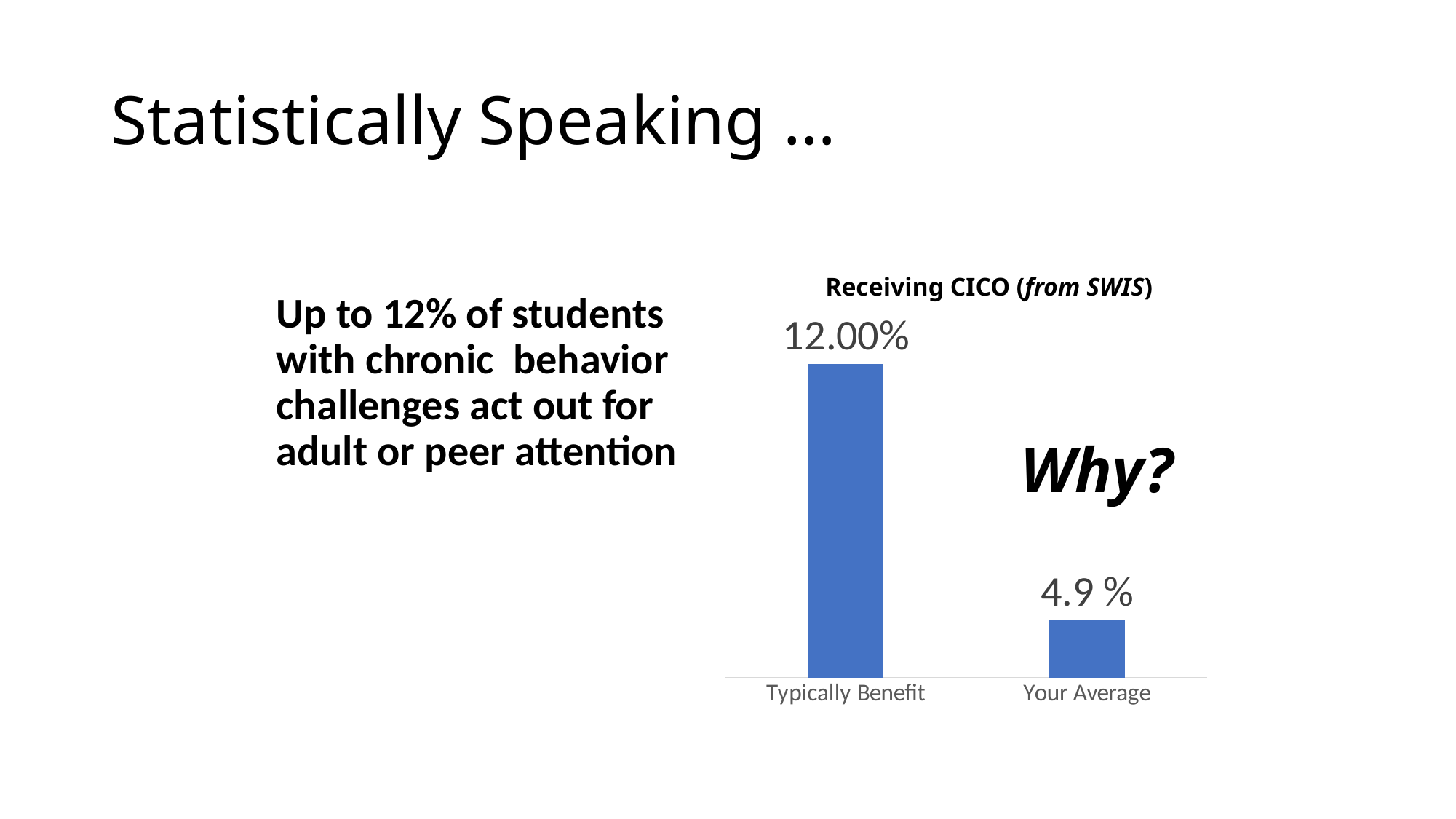
Which category has the lowest value? Your Average How many categories are shown on the chart? 2 What is the value for Your Average? 4.9 % What is the value for Typically Benefit? 12.00% What is the difference between the Typically Benefit value and the Your Average value? 7.1% Which is larger, Typically Benefit or Your Average? Typically Benefit What kind of chart is shown? Bar chart What is the title of the chart? Receiving CICO (from SWIS) Which category has the highest value? Typically Benefit What colour are the bars in the chart? Blue Do the values rise or fall from Typically Benefit to Your Average? Fall